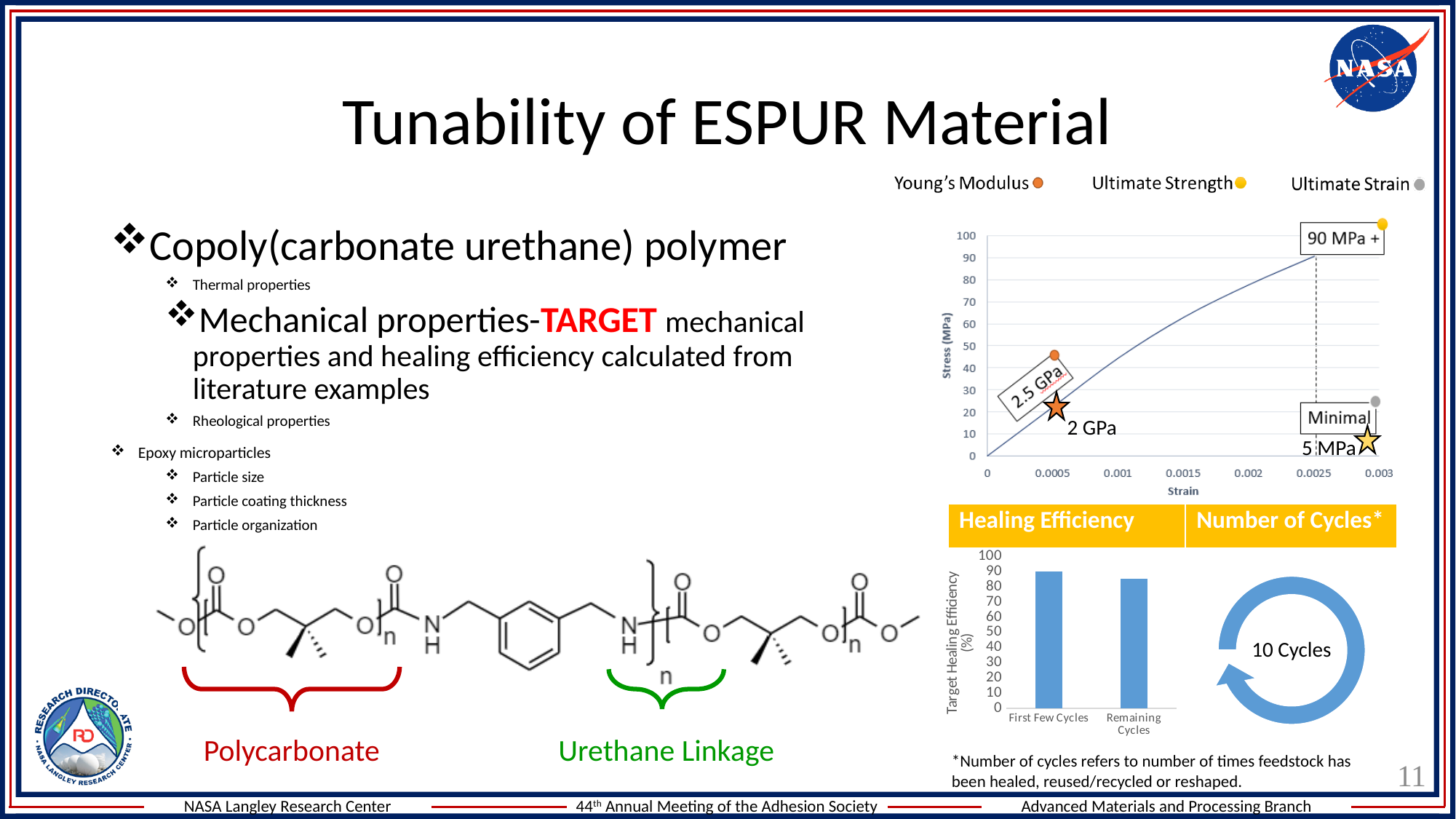
What is the x-axis title of the stress-strain chart? Strain What kind of chart is the Healing Efficiency chart? bar chart In the stress-strain chart, is the stress at a strain of 0.0005 greater or less than 40? less In the stress-strain chart, is the stress at a strain of 0.002 greater or less than 70? greater In the Healing Efficiency chart, is the value for Remaining Cycles greater or less than 70? greater In the stress-strain chart, does the stress rise or fall as strain increases? rises In the Healing Efficiency chart, which category has the higher bar? First Few Cycles How many categories are shown on the x axis of the Healing Efficiency chart? 2 How many series does the legend above the stress-strain chart list? 3 What is the y-axis label of the Healing Efficiency chart? Target Healing Efficiency (%) What kind of chart is the stress-strain chart at the top right? line chart